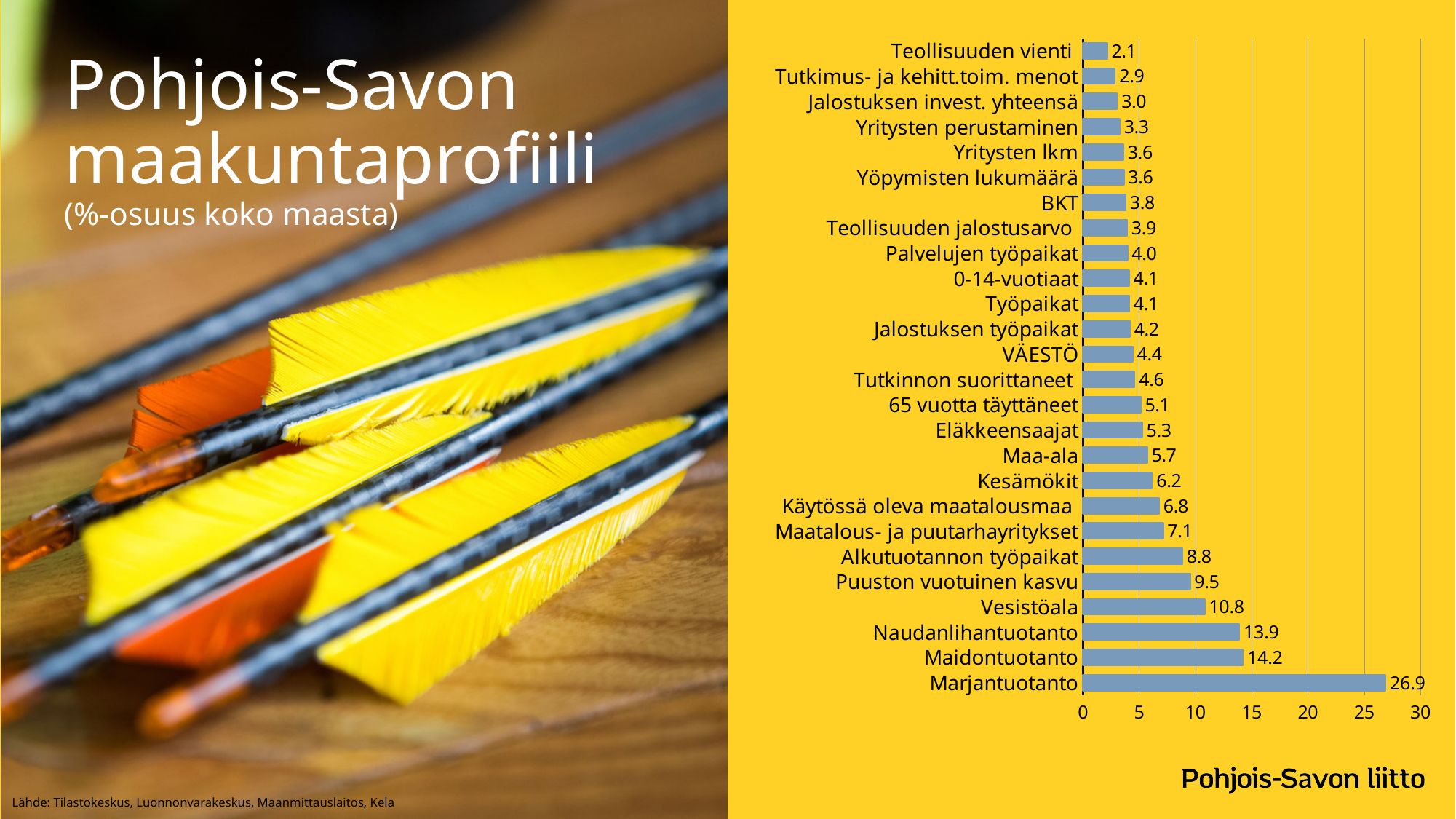
Which is larger, the value for Kesämökit or the value for Maa-ala? Kesämökit What is the difference between the values for Maidontuotanto and Naudanlihantuotanto? 0.3 Which category has the highest value? Marjantuotanto What is the value for Marjantuotanto? 26.9 What is the value for BKT? 3.8 What is the value for Vesistöala? 10.8 What is the subtitle shown under the slide title? (%-osuus koko maasta) What is the difference between the values for Marjantuotanto and Teollisuuden vienti? 24.8 What kind of chart is shown on the slide? Bar chart How many categories are shown in the chart? 26 What is the value for VÄESTÖ? 4.4 Which category has the lowest value? Teollisuuden vienti